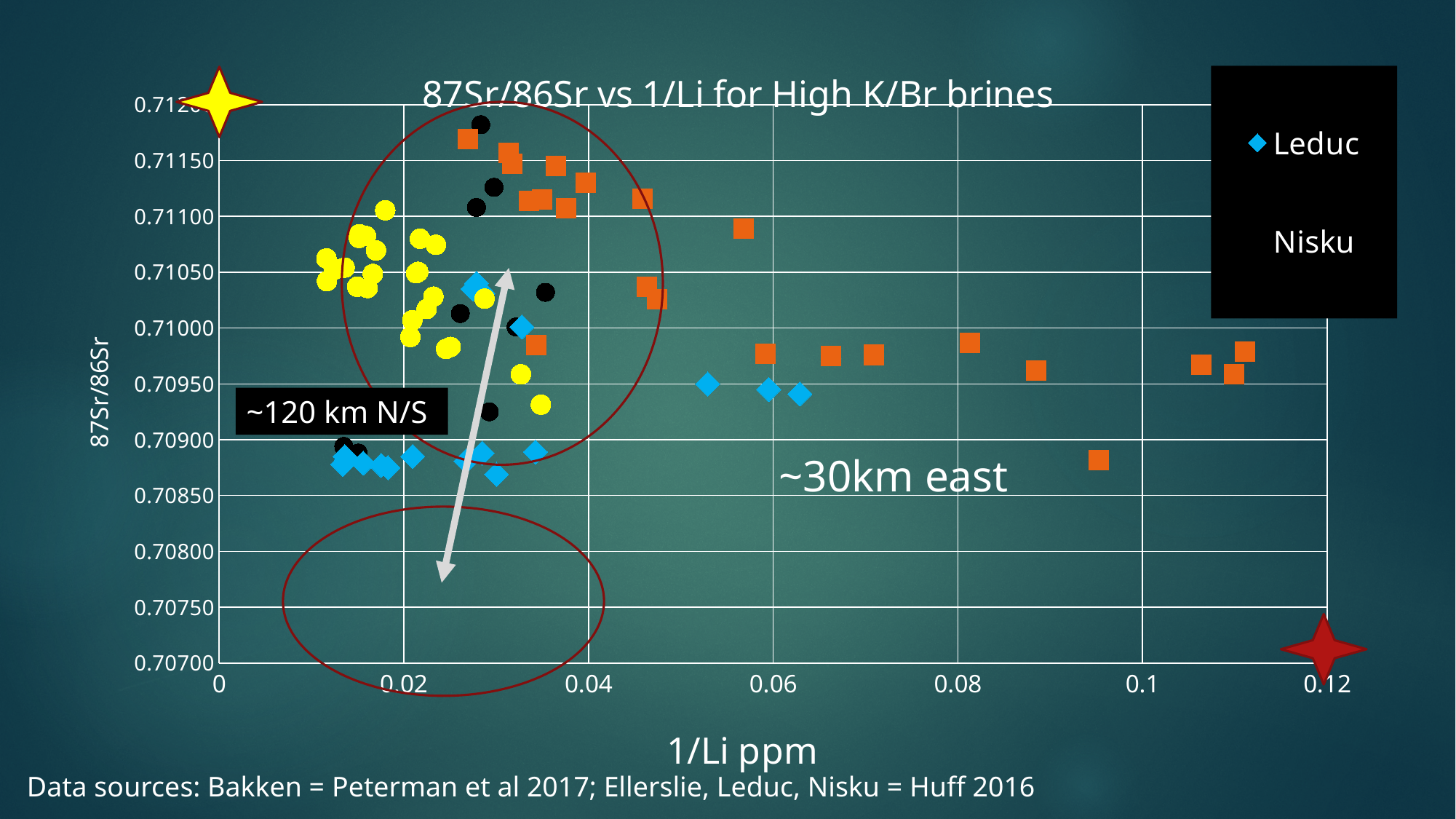
What kind of chart is shown on the slide? Scatter chart Which series names are readable in the chart's legend? Leduc and Nisku What is the title of the chart? 87Sr/86Sr vs 1/Li for High K/Br brines Is the largest 1/Li value among the Leduc (blue diamond) points greater or less than 0.08? less Is the lowest 87Sr/86Sr value among the Leduc (blue diamond) points greater or less than 0.70900? less Is the 1/Li value of the rightmost point on the chart greater or less than 0.1? greater